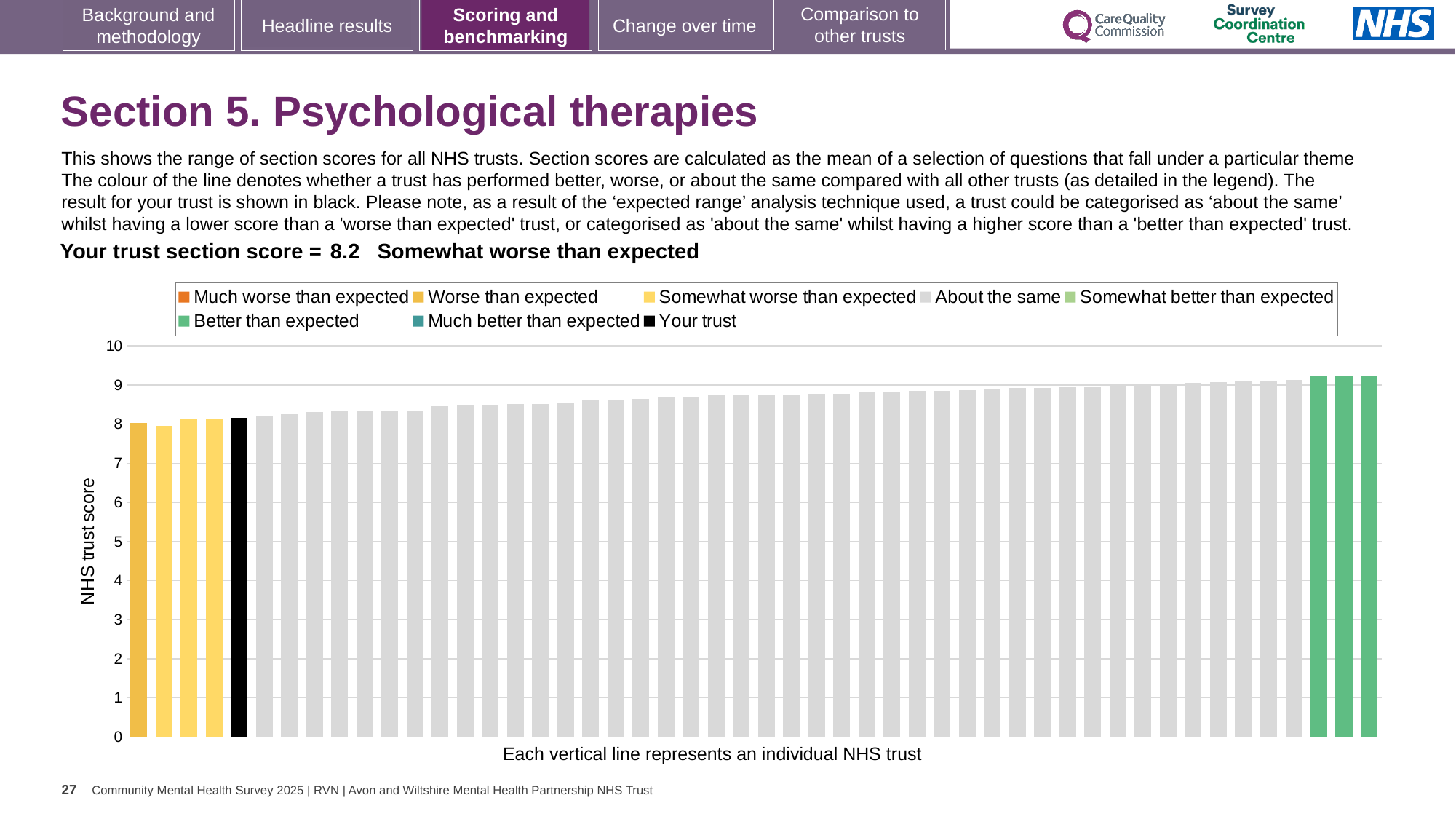
What is the label of the y axis? NHS trust score What is the highest value shown on the y axis? 10 How many entries does the chart legend list? 8 How many bars are coloured green (better than expected) in the chart? 3 Do the bar values rise or fall moving from left to right along the x axis? rise Which performance category is your trust placed in for Section 5? Somewhat worse than expected What does the caption below the x axis say each vertical line represents? an individual NHS trust Is the value of the leftmost bar greater or less than 7? greater What kind of chart is shown on the slide? bar chart Is the value of the tallest bar on the right of the chart greater or less than 9? greater Is the value of the black 'Your trust' bar greater or less than 9? less What is the section score for your trust shown on the slide? 8.2